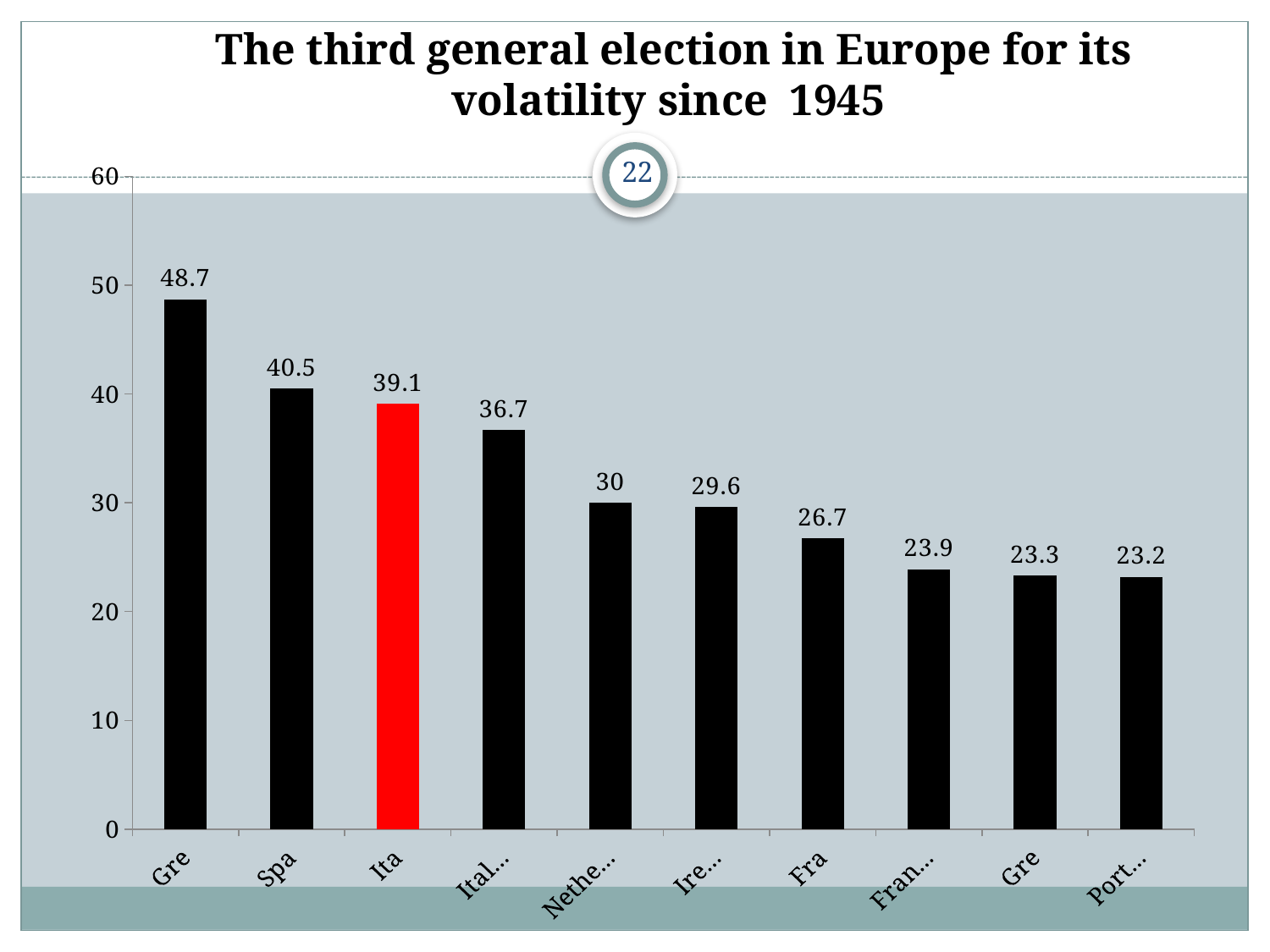
What is the value of the bar labelled Ita? 39.1 What is the difference between the values for Spa and Ita? 1.4 What is the value of the lowest bar in the chart? 23.2 What is the value of the bar labelled Fra? 26.7 Which is larger, the value for Ita or the value for Fra? Ita What is the value of the first bar on the left, labelled Gre? 48.7 What type of chart is shown on the slide? bar chart Which bar has the highest value in the chart? Gre (first bar, 48.7) Do the bar values rise or fall from left to right across the chart? fall What is the value of the bar labelled Spa? 40.5 Which bar is coloured red instead of black? Ita How many bars are plotted in the chart? 10